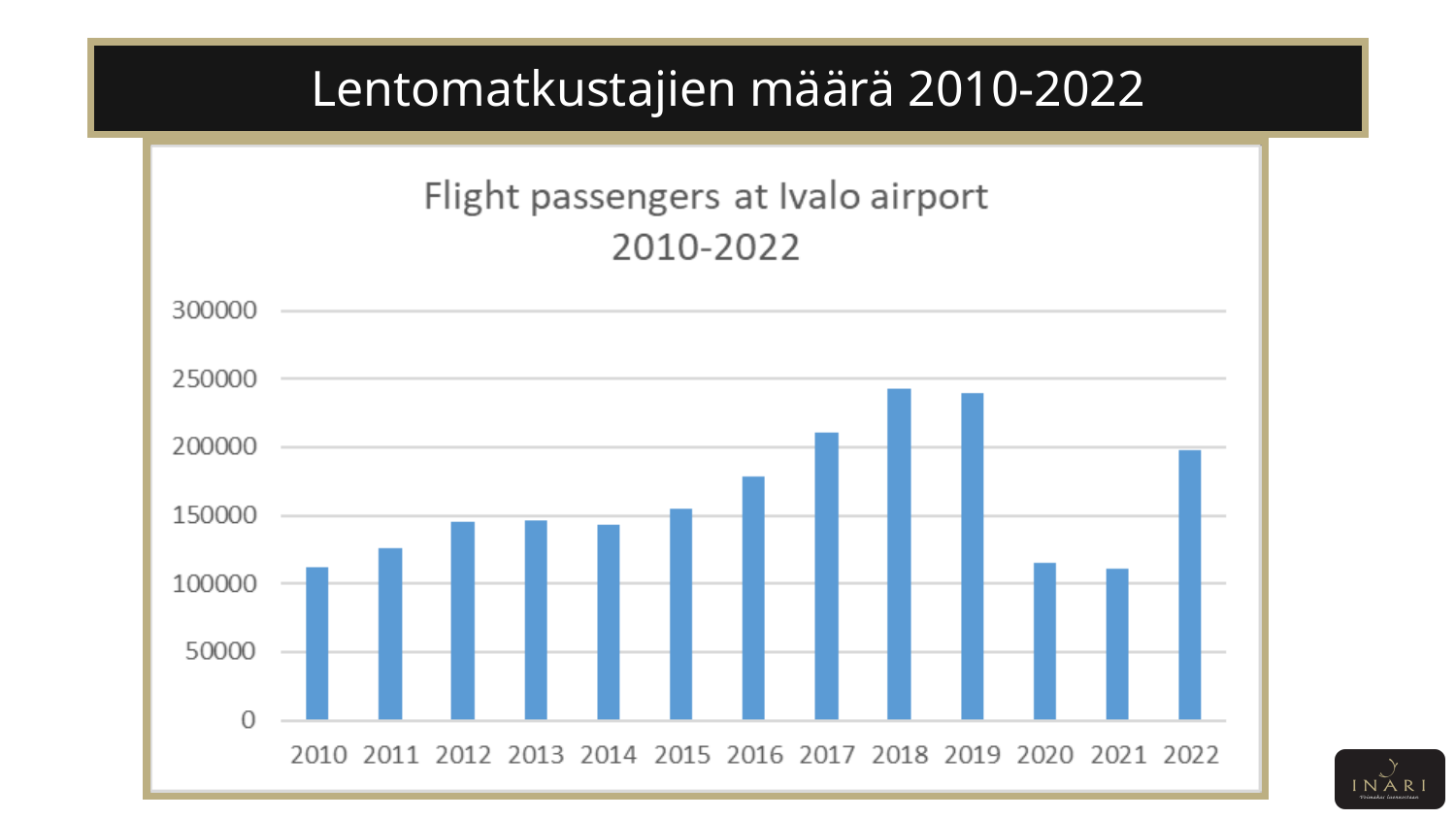
Is the value for 2018 greater or less than 200000? greater Which year has the larger value, 2021 or 2022? 2022 Do the values rise or fall from 2016 to 2018? rise What is the title of the chart? Flight passengers at Ivalo airport 2010-2022 Which year has the larger value, 2018 or 2020? 2018 Is the value for 2020 greater or less than 150000? less Do the values rise or fall from 2019 to 2021? fall What kind of chart is shown on the slide? Bar chart Is the value for 2016 greater or less than 200000? less How many years are plotted on the x axis of the chart? 13